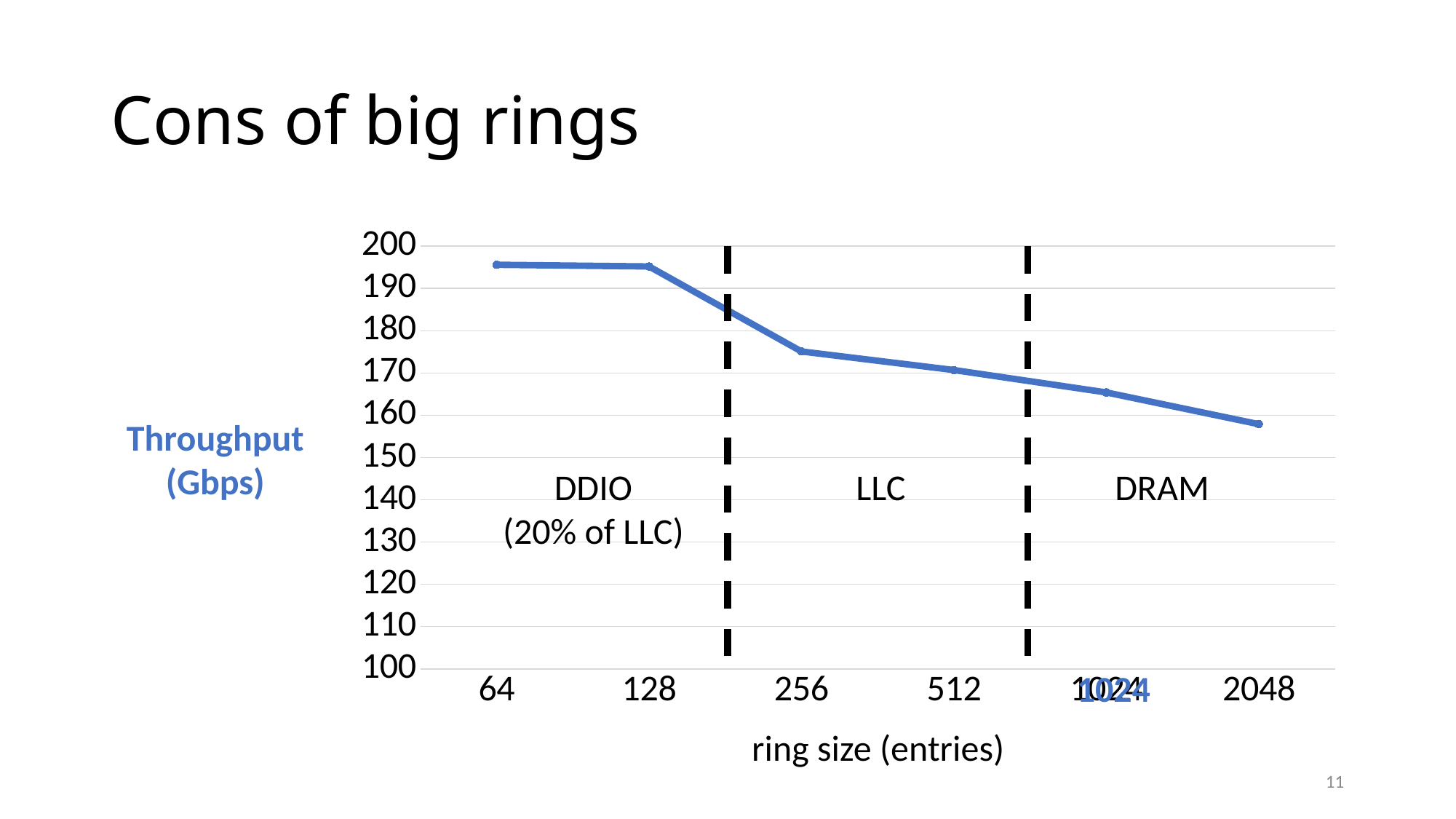
What are the three regions labelled between the dashed lines on the chart? DDIO (20% of LLC), LLC, DRAM Does throughput rise or fall as ring size increases along the x axis? fall Is the throughput for a ring size of 2048 greater or less than 160? less What kind of chart is shown on the slide? line chart Is the throughput for a ring size of 1024 greater or less than 170? less Is the throughput for a ring size of 64 greater or less than 190? greater How many ring sizes are plotted along the x axis? 6 What is the label of the x axis? ring size (entries) Which has higher throughput, a ring size of 128 or a ring size of 512? 128 Which ring size has the lowest throughput? 2048 Which has higher throughput, a ring size of 256 or a ring size of 2048? 256